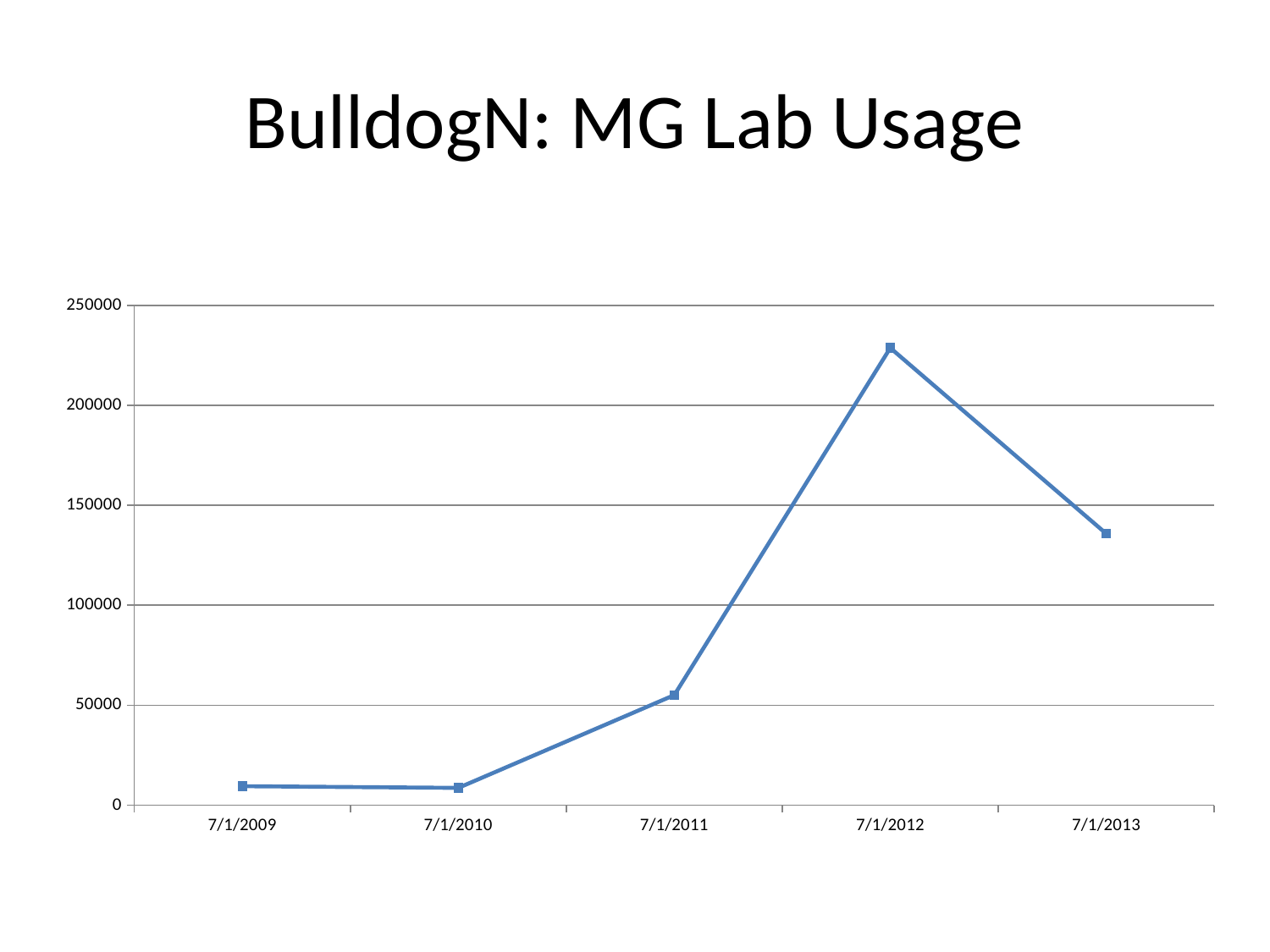
Is the value for 7/1/2011 greater or less than 50000? greater Does the value rise or fall from 7/1/2012 to 7/1/2013? fall Which date has the highest value? 7/1/2012 Does the value rise or fall from 7/1/2010 to 7/1/2012? rise What kind of chart is shown on the slide? line chart Which is larger, the value for 7/1/2012 or the value for 7/1/2013? 7/1/2012 What is the title of the slide? BulldogN: MG Lab Usage Which is larger, the value for 7/1/2013 or the value for 7/1/2011? 7/1/2013 How many data points are plotted on the line? 5 Is the value for 7/1/2012 greater or less than 200000? greater Is the value for 7/1/2009 greater or less than 50000? less